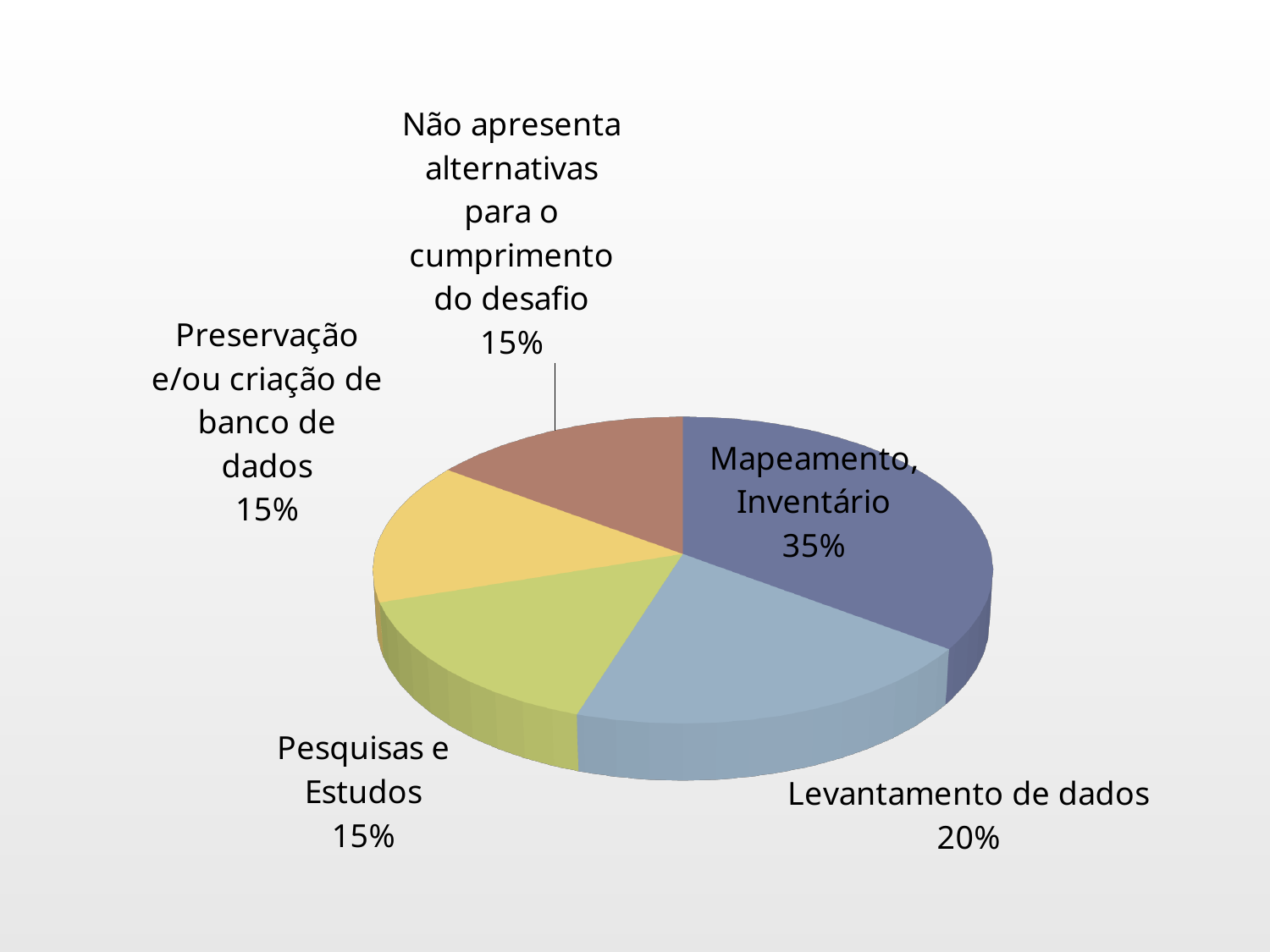
What kind of chart is shown on the slide? pie chart What colour is the slice for "Mapeamento, Inventário"? blue What is the value shown for "Levantamento de dados"? 20% What is the value shown for "Pesquisas e Estudos"? 15% Which category has the largest slice of the pie? Mapeamento, Inventário Which is larger, the share for "Levantamento de dados" or the share for "Pesquisas e Estudos"? Levantamento de dados How many slices does the pie chart have? 5 What is the value shown for "Não apresenta alternativas para o cumprimento do desafio"? 15% What share of the pie does "Mapeamento, Inventário" represent? 35% What is the difference between the shares of "Mapeamento, Inventário" and "Levantamento de dados"? 15% How many categories share the same value of 15%? 3 What is the value shown for "Preservação e/ou criação de banco de dados"? 15%